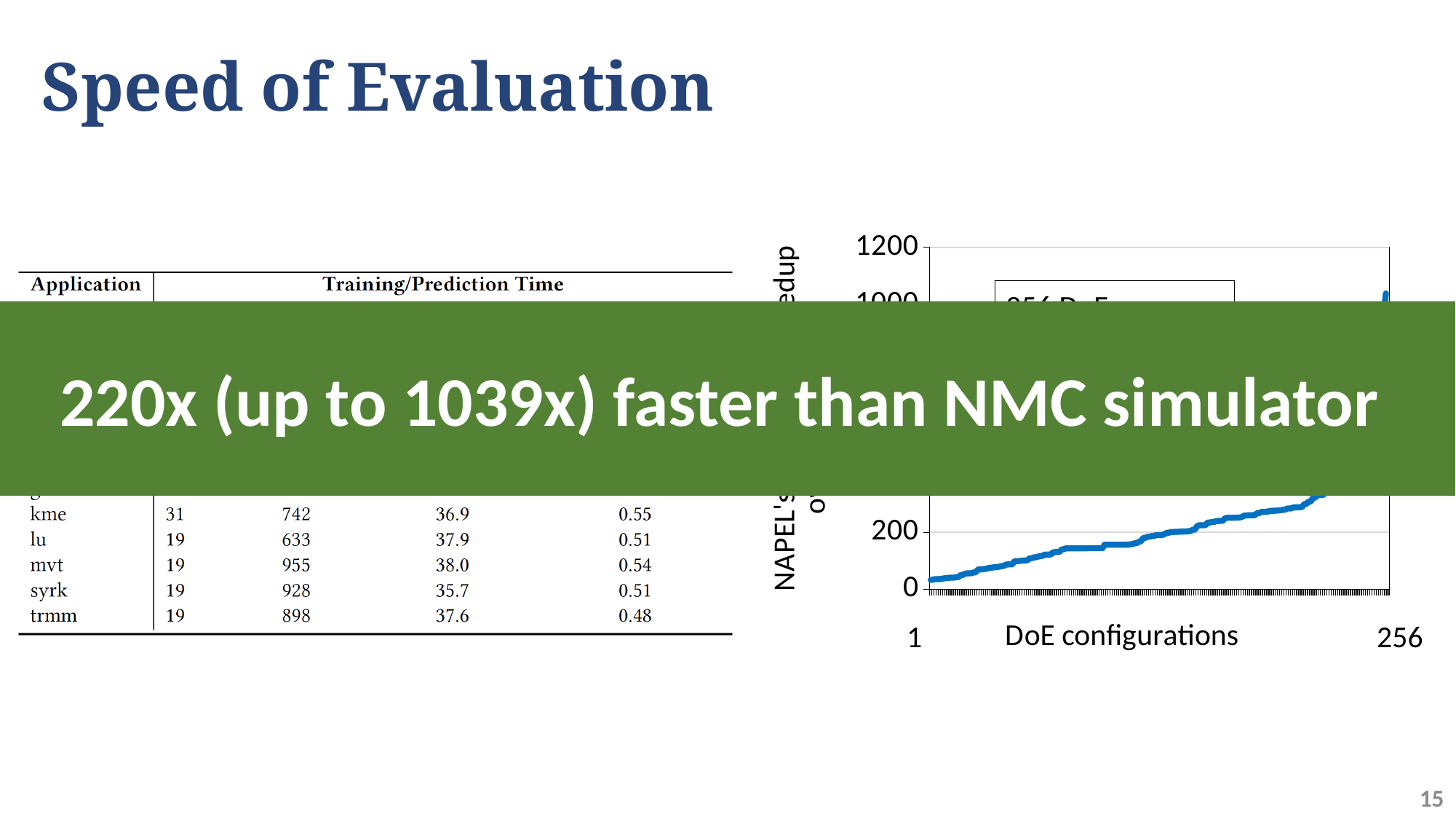
How many lines are plotted in the chart on the right? 1 In the chart on the right, which DoE configuration has the lowest speedup, 1 or 256? 1 What is the last x-axis label shown on the chart on the right? 256 In the chart on the right, do the values rise or fall as you move along the x axis from configuration 1 to 256? rise What is the highest tick value shown on the y axis of the chart on the right? 1200 What kind of chart is shown on the right side of the slide? line chart What is the title of the x axis of the chart on the right? DoE configurations In the chart on the right, is the value for DoE configuration 256 greater or less than 200? greater In the chart on the right, which DoE configuration has the higher value, 1 or 256? 256 In the chart on the right, is the value for the first DoE configuration greater or less than 200? less